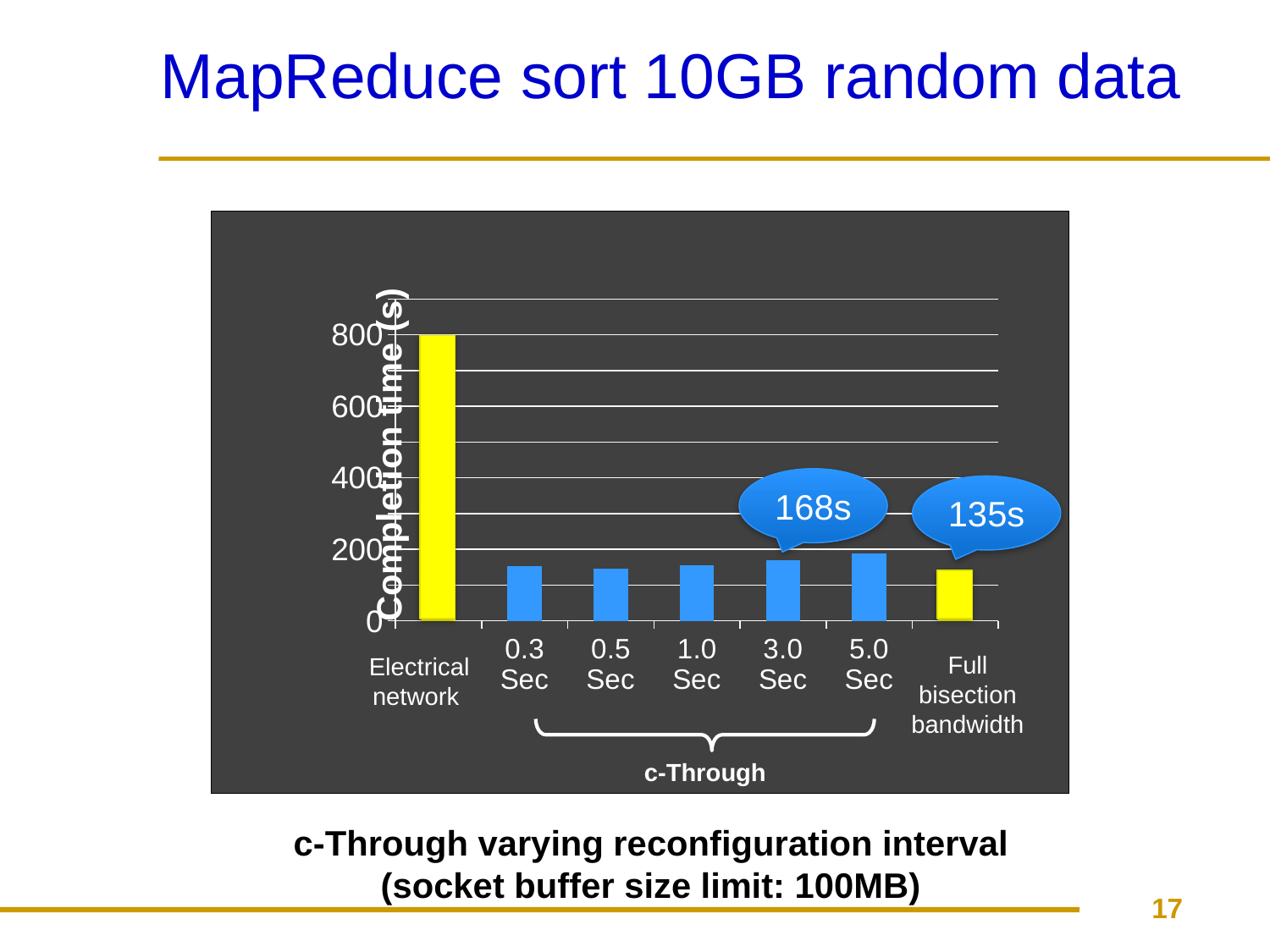
What is the difference in completion time between the 3.0 Sec interval and Full bisection bandwidth? 33s Do the completion times rise or fall from the 1.0 Sec interval to the 5.0 Sec interval? rise What is the label of the y axis? Completion time (s) Which category has the highest completion time? Electrical network What is the completion time for Full bisection bandwidth? 135s Which has the larger completion time, the 5.0 Sec interval or the 0.3 Sec interval? 5.0 Sec Which has the larger completion time, Electrical network or Full bisection bandwidth? Electrical network How many categories are plotted on the x axis? 7 What type of chart is shown on the slide? bar chart What is the completion time for the 3.0 Sec reconfiguration interval? 168s Is the completion time for Electrical network greater or less than 600? greater